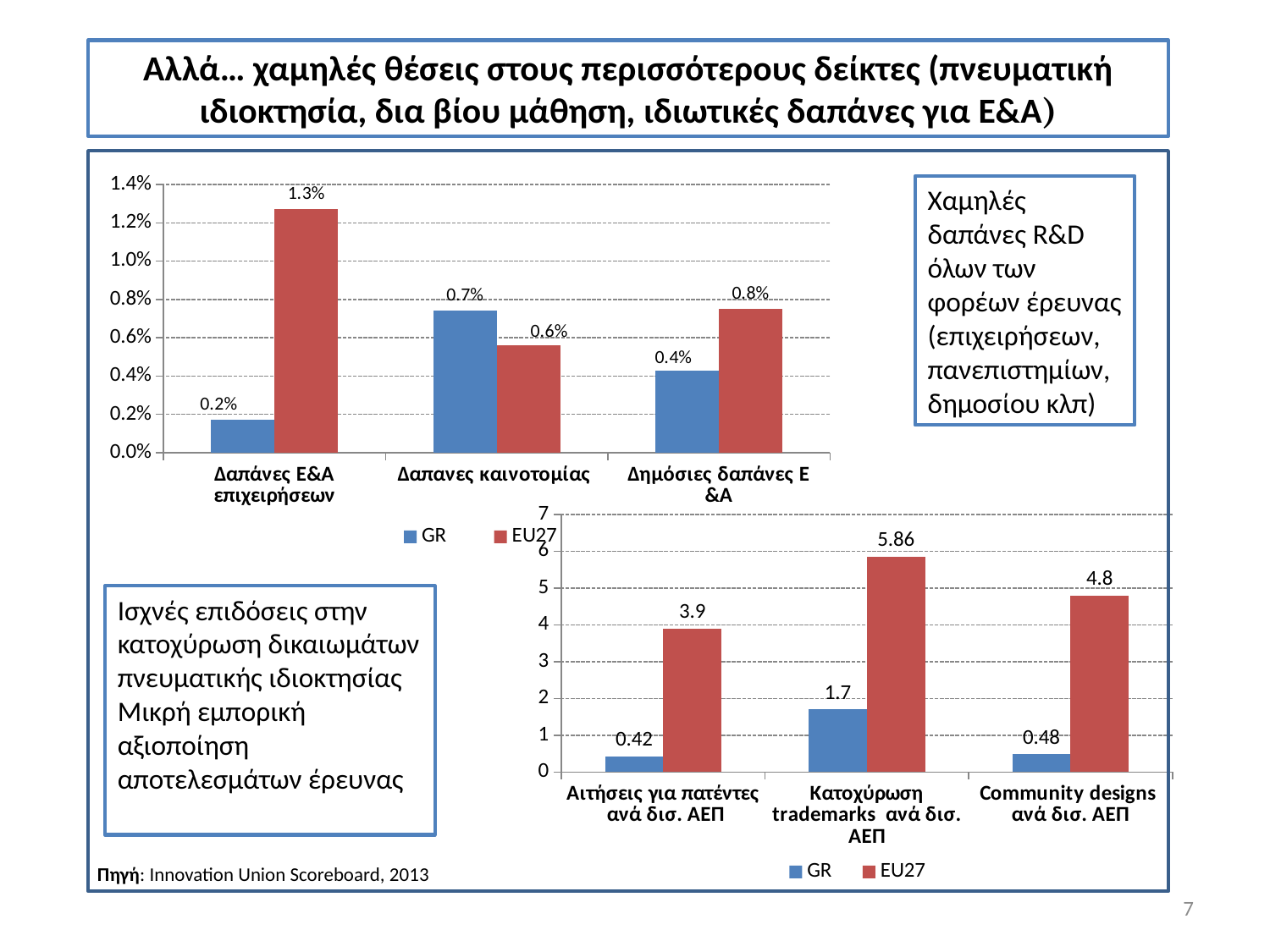
What type of chart is the bottom-right chart? Bar chart In the top-left chart, how many series does the legend list? 2 In the top-left chart, is the GR value or the EU27 value larger for Δαπανες καινοτομίας? GR In the bottom-right chart, which colour represents the EU27 series? Red In the bottom-right chart, which category has the lowest GR value? Αιτήσεις για πατέντες ανά δισ. ΑΕΠ In the bottom-right chart, what is the difference between the EU27 and GR values for Κατοχύρωση trademarks ανά δισ. ΑΕΠ? 4.16 In the bottom-right chart, how many categories are shown on the x axis? 3 In the bottom-right chart, what is the GR value for Αιτήσεις για πατέντες ανά δισ. ΑΕΠ? 0.42 In the top-left chart, what is the EU27 value for Δαπάνες Ε&Α επιχειρήσεων? 1.3% In the top-left chart, what is the GR value for Δημόσιες δαπάνες Ε&Α? 0.4% In the top-left chart, which category has the highest EU27 value? Δαπάνες Ε&Α επιχειρήσεων In the bottom-right chart, what is the EU27 value for Κατοχύρωση trademarks ανά δισ. ΑΕΠ? 5.86